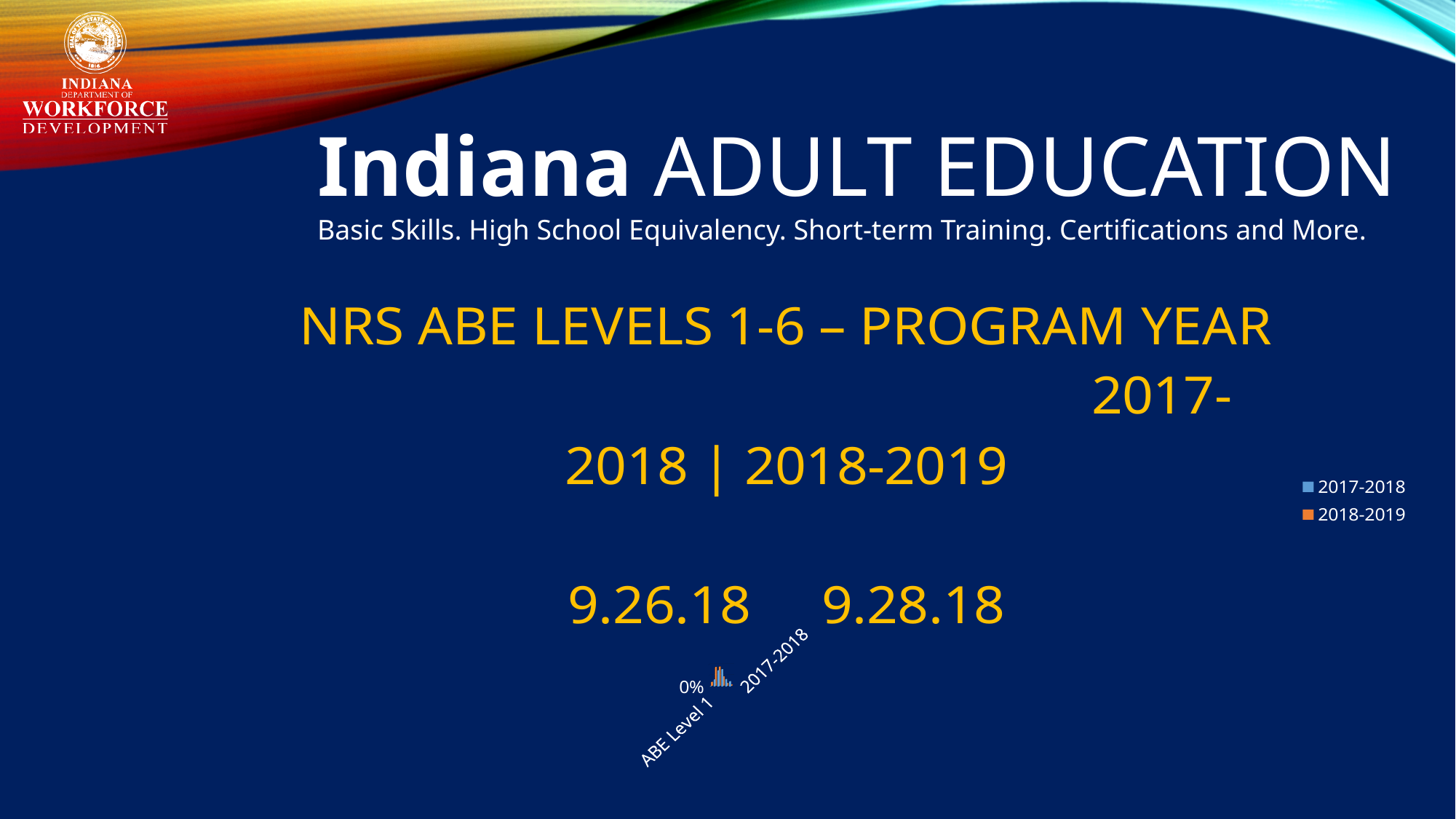
What is the lowest value label shown on the chart's axis? 0% What are the two series named in the chart legend? 2017-2018 and 2018-2019 Which series is shown in orange in the chart legend? 2018-2019 What kind of chart is shown on the slide? Bar chart How many series does the chart legend list? 2